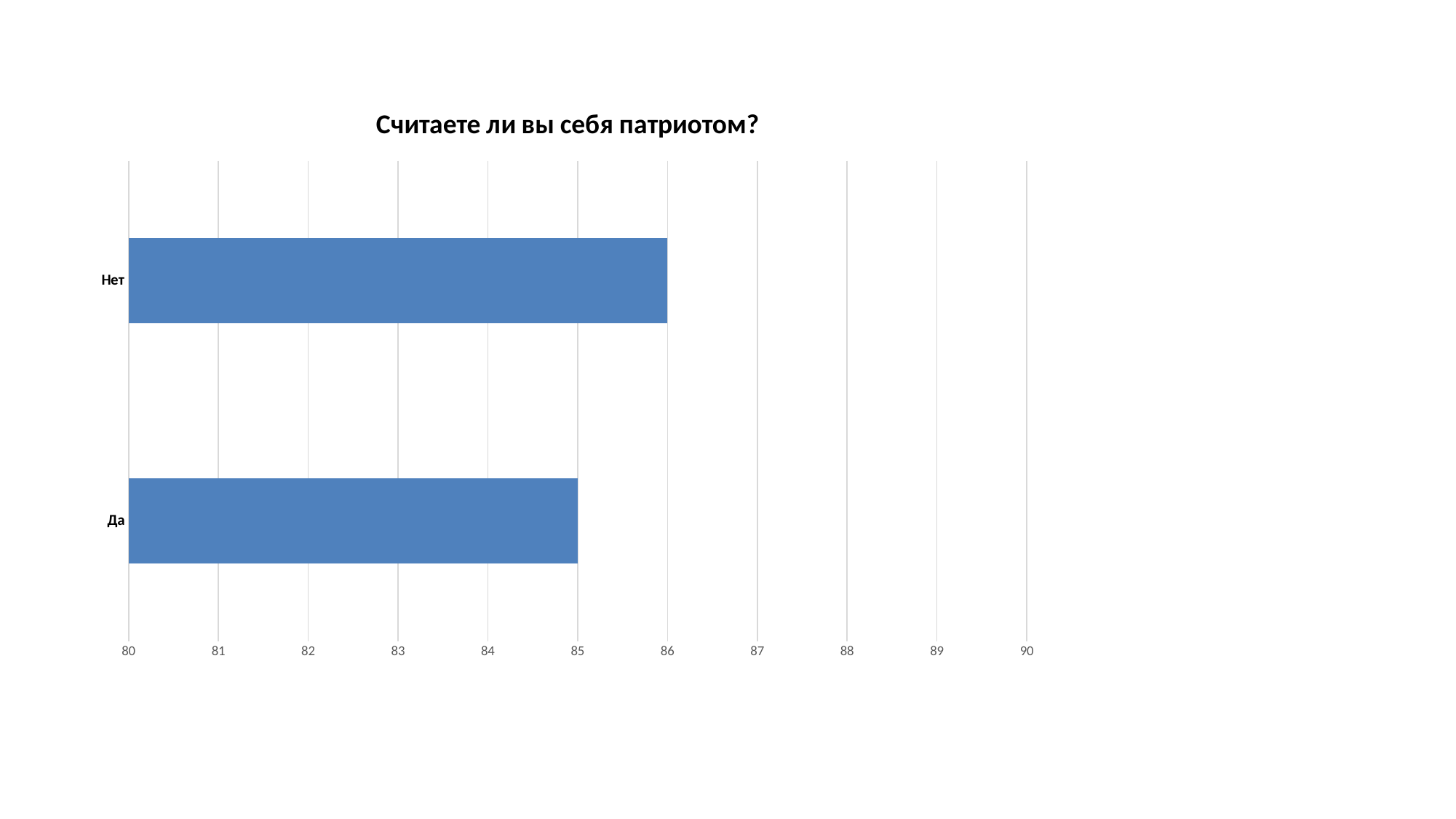
What is the highest value shown on the horizontal axis? 90 Is the value for Нет greater or less than 87? less What kind of chart is shown on the slide? bar chart What is the title of the chart? Считаете ли вы себя патриотом? Which category has the highest value? Нет How many categories are shown in the chart? 2 Which category has the lowest value? Да What is the value for Да? 85 What is the difference between the values for Нет and Да? 1 Which is larger, the value for Да or the value for Нет? Нет Is the value for Да greater or less than 84? greater What is the value for Нет? 86